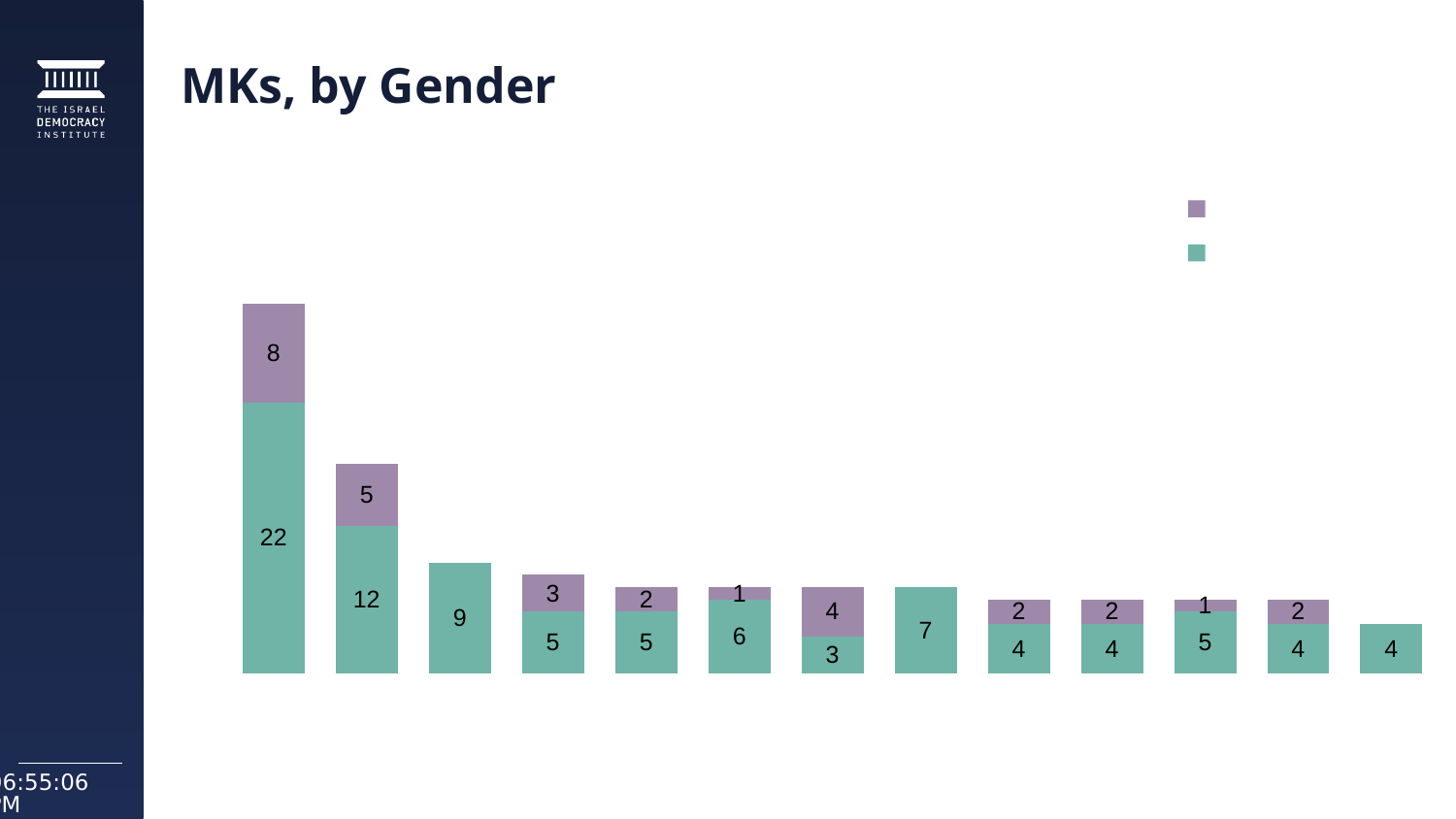
What kind of chart is shown on the slide? stacked bar chart What is the value of the purple segment of the first (leftmost) bar? 8 In the seventh bar from the left, which segment is larger, the green or the purple? purple What is the title of the chart? MKs, by Gender What is the value of the green segment of the third bar from the left? 9 What is the difference between the green segments of the first and second bars? 10 What is the total of the first (leftmost) stacked bar? 30 How many series does the legend list? 2 What is the total of the second bar from the left? 17 Which bar is the tallest in the chart? the first (leftmost) bar What is the value of the green segment of the first (leftmost) bar? 22 How many bars are plotted in the chart? 13